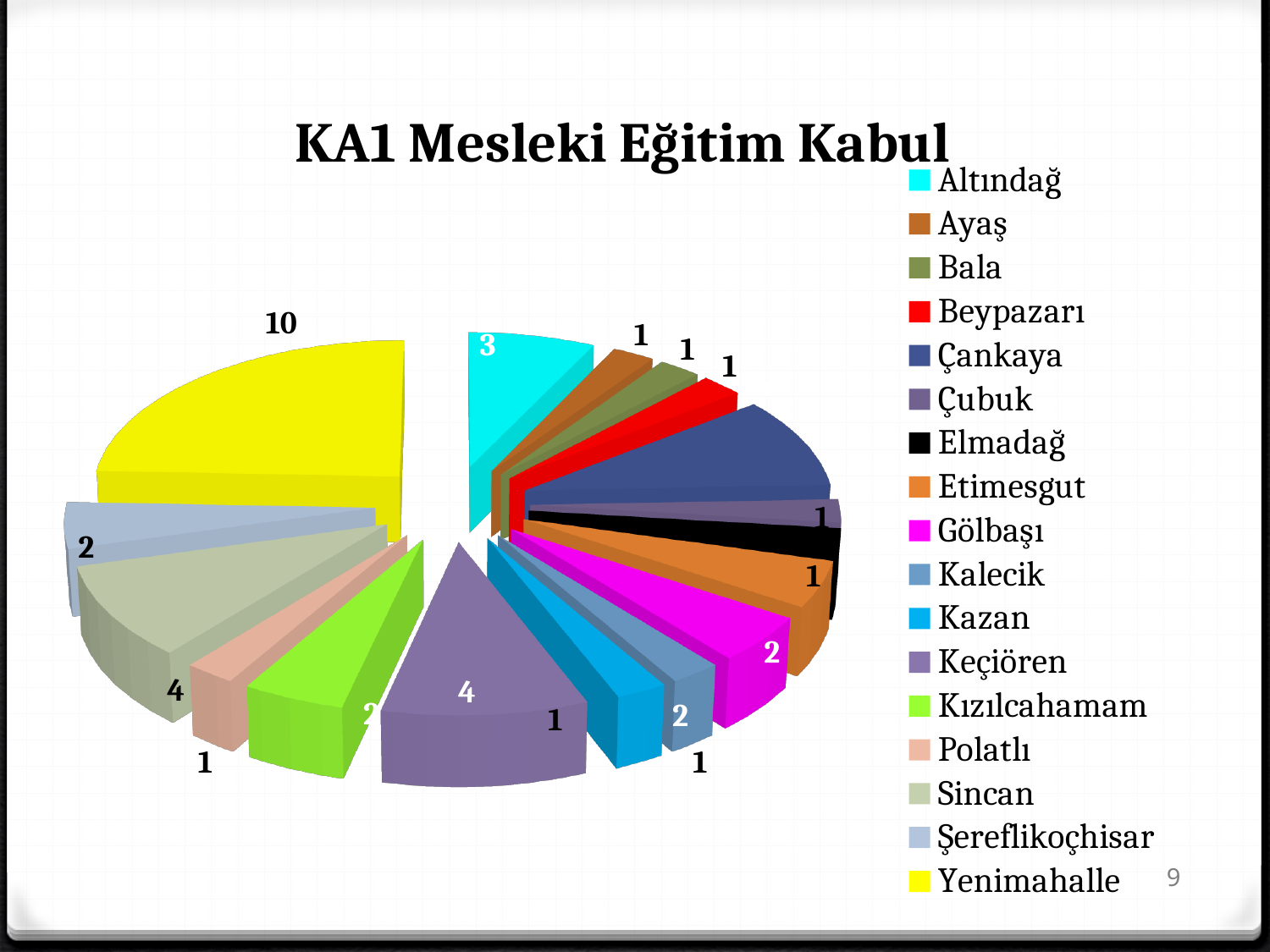
What is the difference between the values for Yenimahalle and Altındağ? 7 What is the value for Sincan? 4 What is the value for Keçiören? 4 What is the value for Şereflikoçhisar? 2 How many categories does the legend list? 17 What is the title of the chart? KA1 Mesleki Eğitim Kabul Which is larger, the value for Yenimahalle or the value for Keçiören? Yenimahalle What type of chart is shown on the slide? pie chart What is the value for Yenimahalle? 10 What is the value for Ayaş? 1 Which category has the largest slice? Yenimahalle What is the value for Altındağ? 3